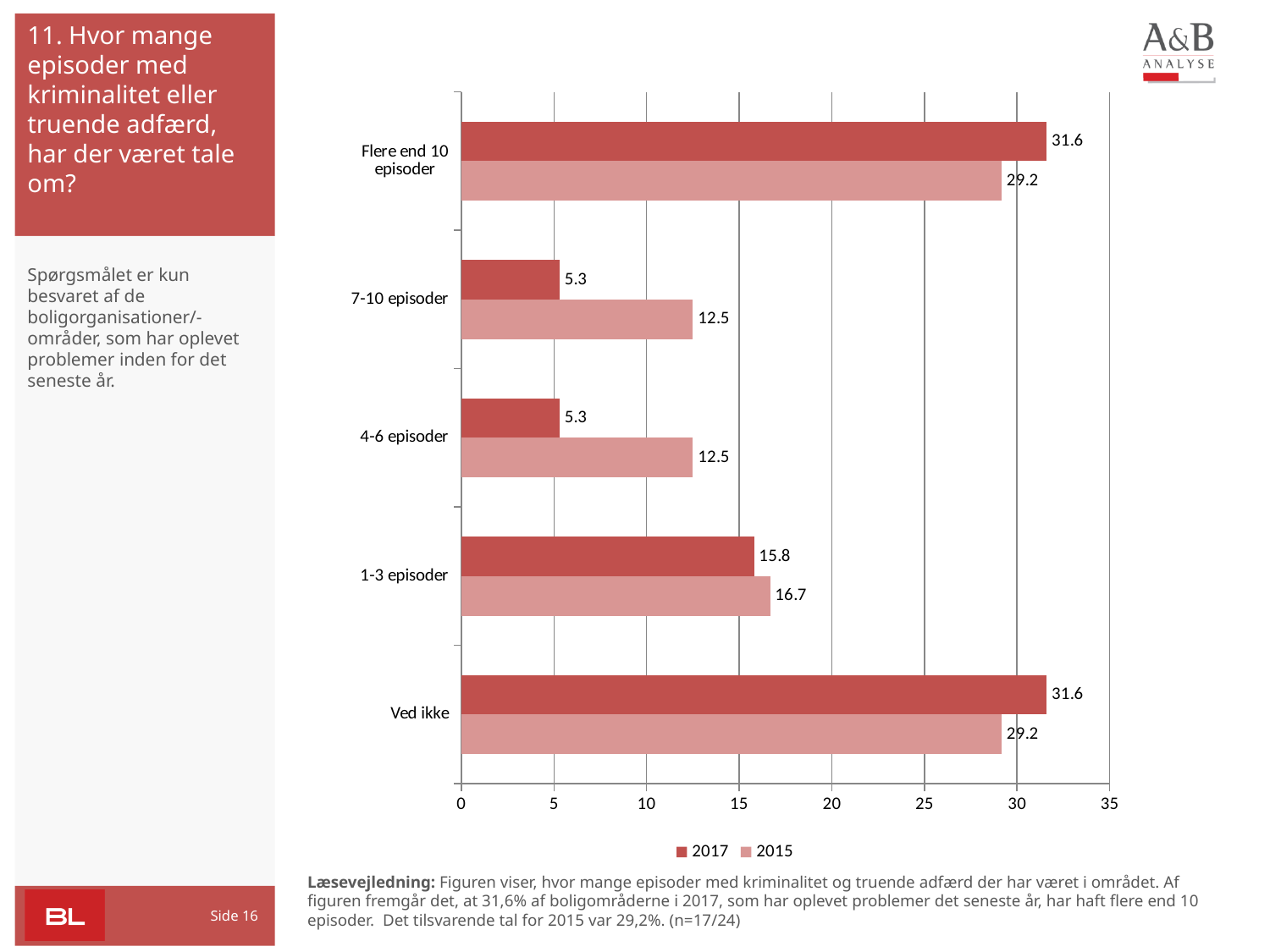
What is the difference between the 2017 and 2015 values for 'Flere end 10 episoder'? 2.4 How many categories are shown on the chart? 5 What kind of chart is shown on the slide? bar chart For '1-3 episoder', which year has the larger value, 2017 or 2015? 2015 Is the 2017 value for 'Ved ikke' greater or less than 30? greater How many series does the legend list? 2 For '4-6 episoder', which year has the larger value, 2017 or 2015? 2015 What is the 2017 value for '1-3 episoder'? 15.8 What is the 2015 value for '7-10 episoder'? 12.5 What is the 2015 value for 'Ved ikke'? 29.2 What is the difference between the 2015 and 2017 values for '7-10 episoder'? 7.2 What is the 2017 value for 'Flere end 10 episoder'? 31.6